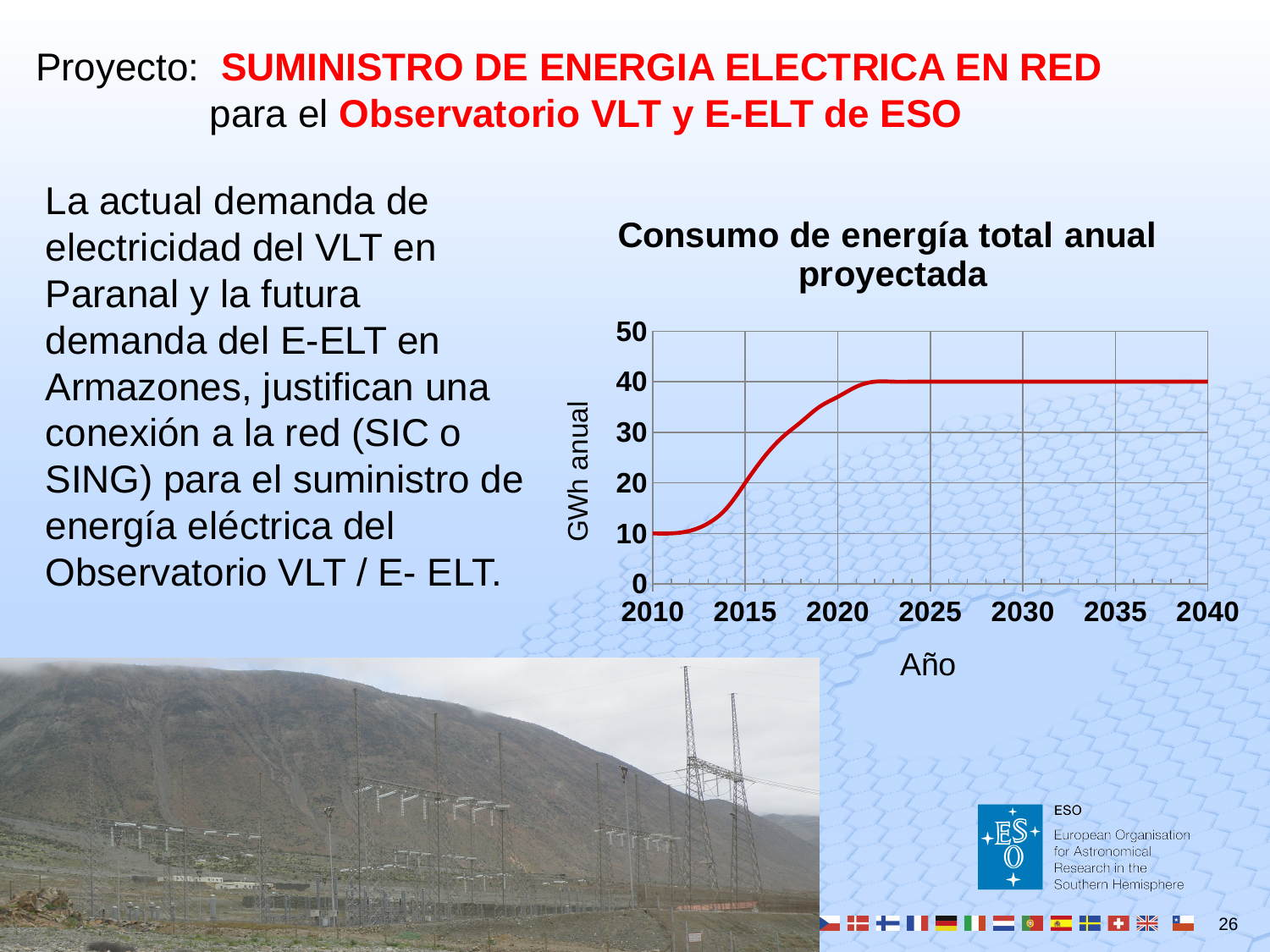
Is the value for 2020 greater or less than 30? greater Is the value for 2012 greater or less than 20? less Is the value for 2035 greater or less than 50? less What is the value of the line in 2040? 40 What kind of chart is shown on the slide? line chart What is the first year shown on the x axis? 2010 How does the value change along the x axis from 2010 to 2040? rises, then levels off What is the label of the y axis of the chart? GWh anual What is the title of the chart? Consumo de energía total anual proyectada Which year has a higher value, 2010 or 2030? 2030 What is the value of the line in 2010? 10